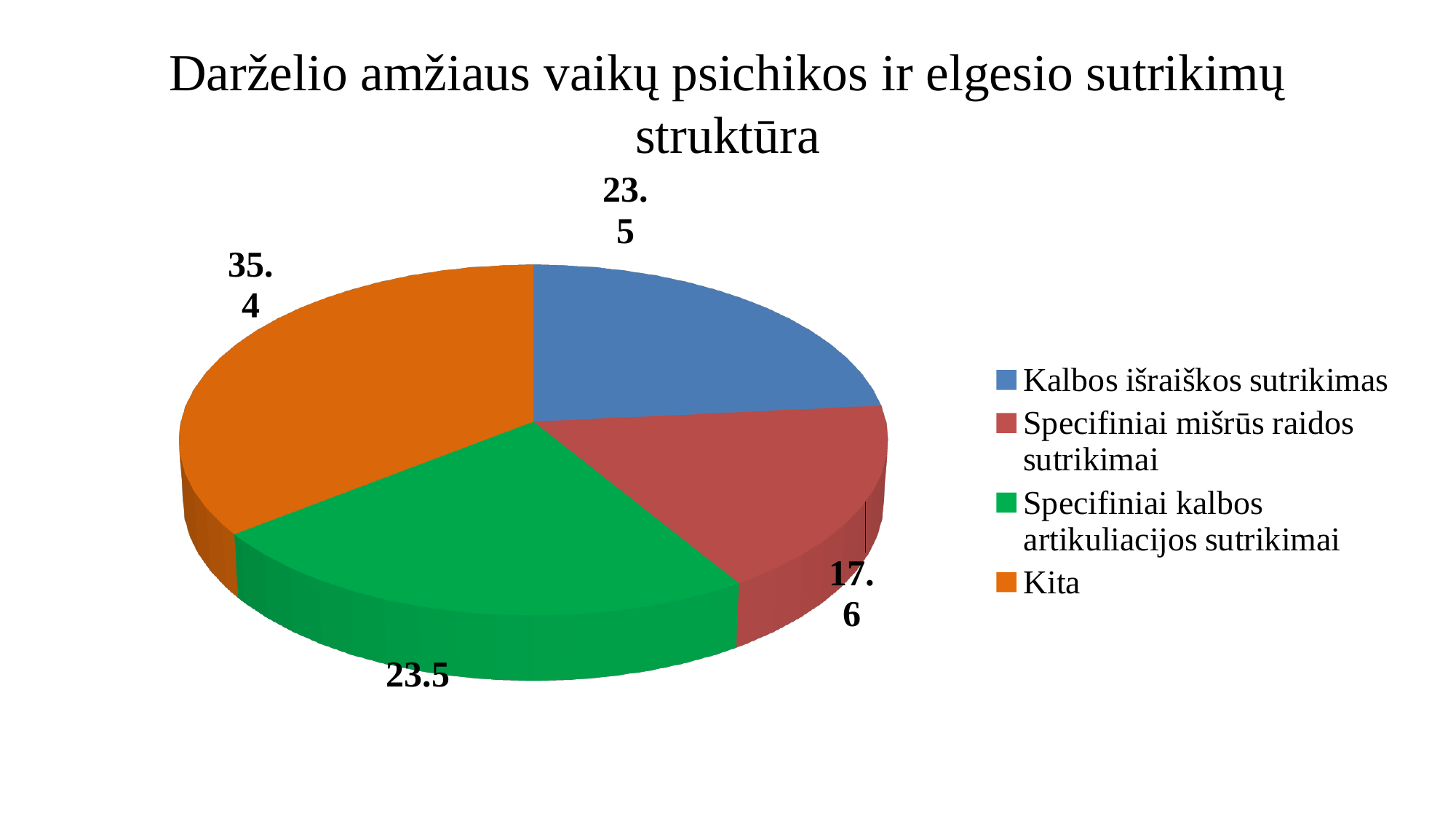
Which category has the smallest slice of the pie? Specifiniai mišrūs raidos sutrikimai What value is shown for the Kita slice? 35.4 What is the difference between the values for Kita and Kalbos išraiškos sutrikimas? 11.9 Which category has the largest slice of the pie? Kita What value is shown for the Specifiniai mišrūs raidos sutrikimai slice? 17.6 What kind of chart is shown on the slide? Pie chart What value is shown for the Kalbos išraiškos sutrikimas slice? 23.5 How many slices does the pie chart have? 4 What is the difference between the values for Kita and Specifiniai mišrūs raidos sutrikimai? 17.8 Which is larger, the value for Kita or the value for Specifiniai kalbos artikuliacijos sutrikimai? Kita What colour is the Kita slice? Orange What value is shown for the Specifiniai kalbos artikuliacijos sutrikimai slice? 23.5